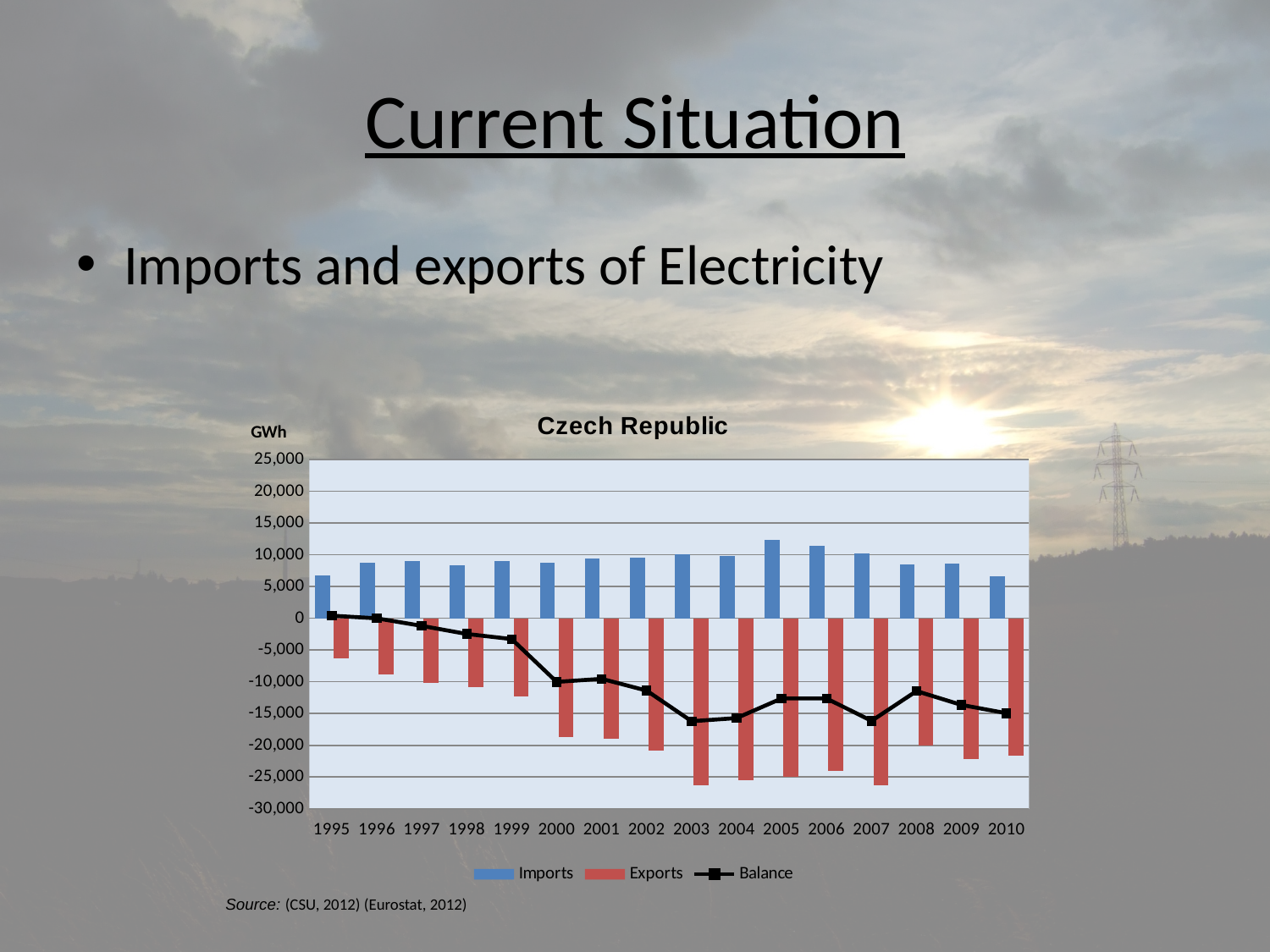
How many years are shown on the x axis of the Czech Republic chart? 16 Which year has the larger Imports value, 2005 or 2010? 2005 What unit is shown on the vertical axis of the chart? GWh Is the Exports value for 1995 greater or less than -10,000? greater In which year is the Imports bar highest? 2005 Is the Balance value for 2003 greater or less than -15,000? less How many series does the legend of the Czech Republic chart list? 3 Does the Balance line generally rise or fall from 1995 to 2010? Fall What kind of chart is shown on the slide? A bar chart with a line series Is the Imports value for 1995 greater or less than 10,000? less What is the title of the chart? Czech Republic